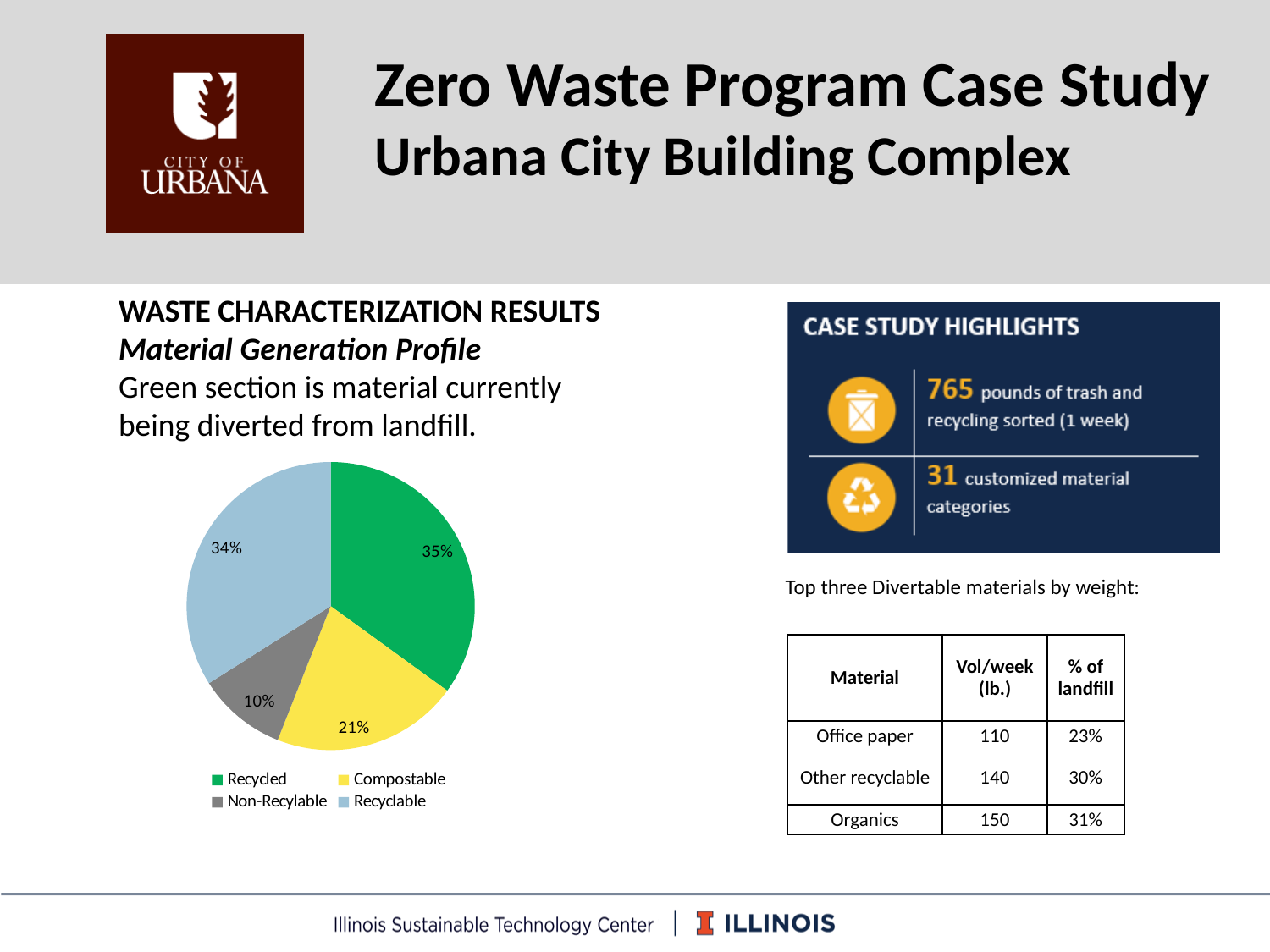
What percentage of the pie chart is Non-Recylable? 10% What percentage of the pie chart is Recycled? 35% What colour is the Recycled slice in the pie chart? green How many slices does the pie chart have? 4 What percentage of the pie chart is Compostable? 21% Which slice is larger, Compostable or Non-Recylable? Compostable What percentage of the pie chart is Recyclable? 34% What type of chart is shown on the slide? pie chart How many entries does the pie chart legend list? 4 Which category has the largest slice of the pie chart? Recycled Which category has the smallest slice of the pie chart? Non-Recylable What is the difference in percentage points between the Recycled and Compostable slices? 14